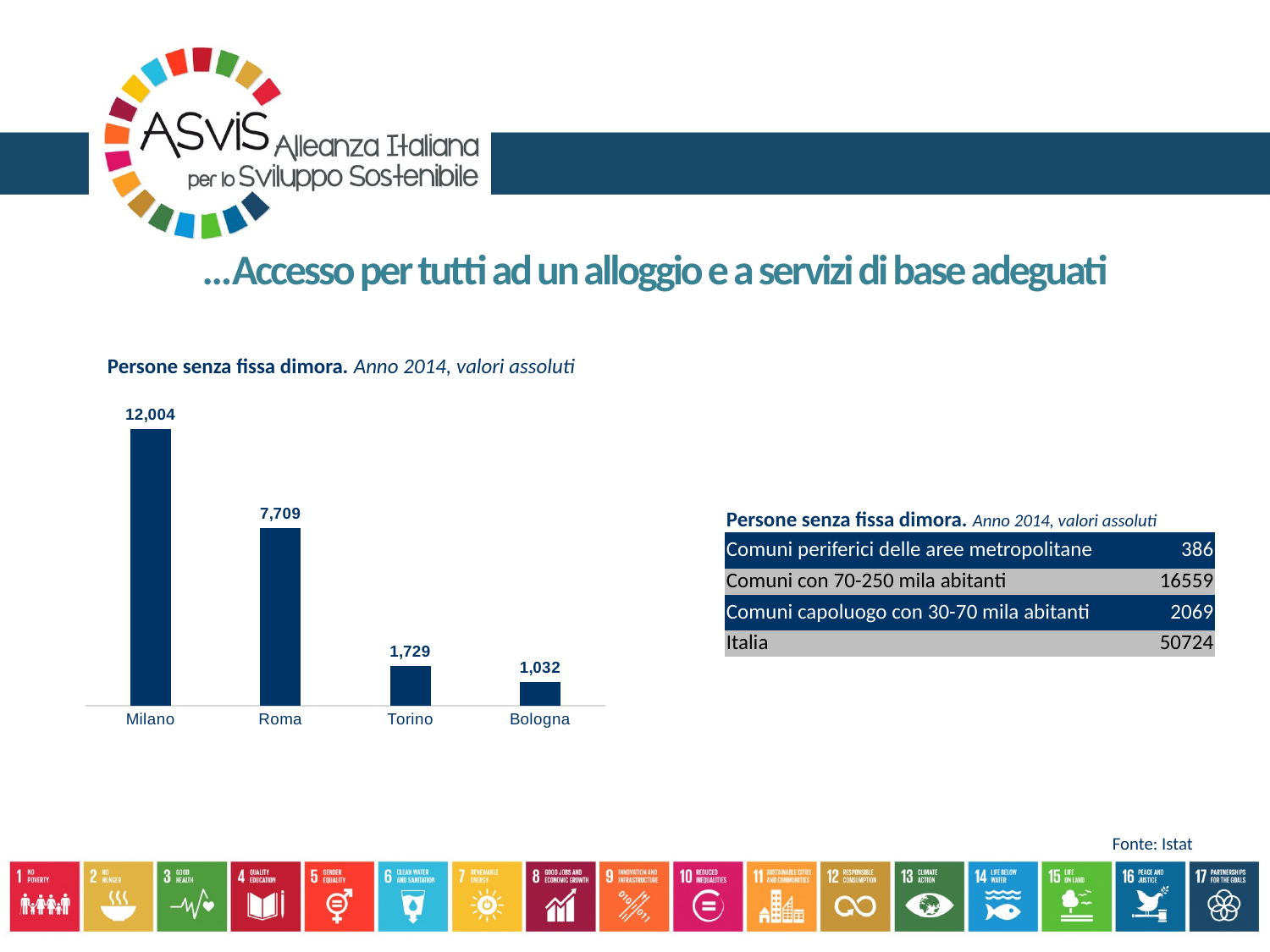
What is the value for Milano in the bar chart? 12,004 What is the difference between the values for Torino and Bologna in the bar chart? 697 What kind of chart is used to show the persone senza fissa dimora by city? Bar chart What is the difference between the values for Milano and Roma in the bar chart? 4,295 Which city has the lowest value in the bar chart? Bologna What is the value for Roma in the bar chart? 7,709 How many cities are shown in the bar chart? 4 What is the title of the bar chart? Persone senza fissa dimora. Anno 2014, valori assoluti What is the value for Bologna in the bar chart? 1,032 Which city has the highest value in the bar chart? Milano What is the value for Torino in the bar chart? 1,729 Which has a larger value in the bar chart, Roma or Torino? Roma